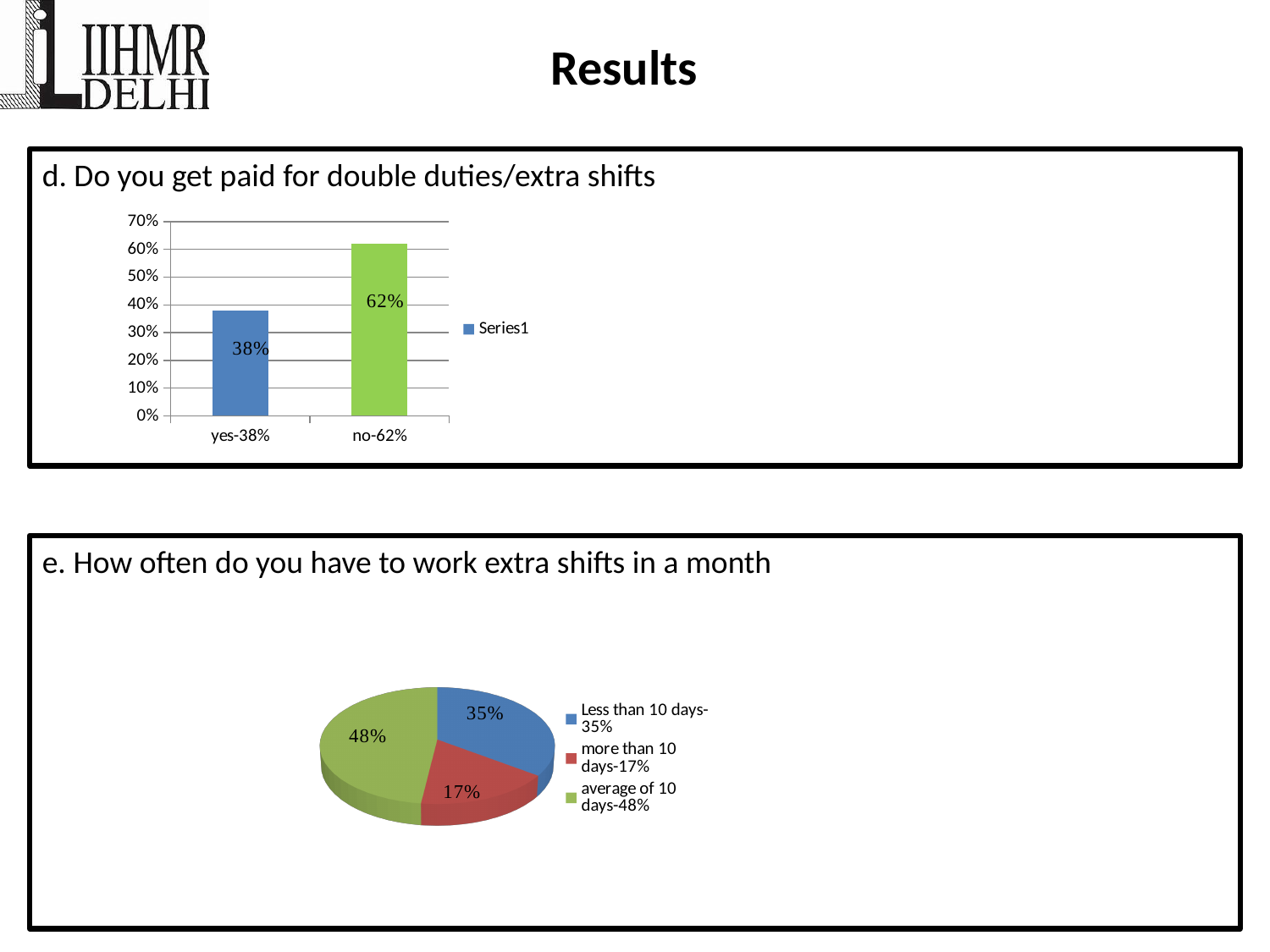
In the chart 'd. Do you get paid for double duties/extra shifts', what is the value for 'no-62%'? 62% In the chart 'e. How often do you have to work extra shifts in a month', which slice is the largest? average of 10 days-48% In the chart 'd. Do you get paid for double duties/extra shifts', what series name does the legend show? Series1 In the chart 'd. Do you get paid for double duties/extra shifts', which category has the highest value? no-62% In the chart 'd. Do you get paid for double duties/extra shifts', what is the value for 'yes-38%'? 38% In the chart 'e. How often do you have to work extra shifts in a month', how many slices does the pie have? 3 In the chart 'e. How often do you have to work extra shifts in a month', which slice is the smallest? more than 10 days-17% In the chart 'd. Do you get paid for double duties/extra shifts', what kind of chart is shown? bar chart In the chart 'd. Do you get paid for double duties/extra shifts', how many categories are plotted? 2 In the chart 'e. How often do you have to work extra shifts in a month', what share of the pie is 'more than 10 days-17%'? 17% In the chart 'd. Do you get paid for double duties/extra shifts', what is the difference between the 'no-62%' and 'yes-38%' values? 24% In the chart 'e. How often do you have to work extra shifts in a month', what kind of chart is shown? pie chart